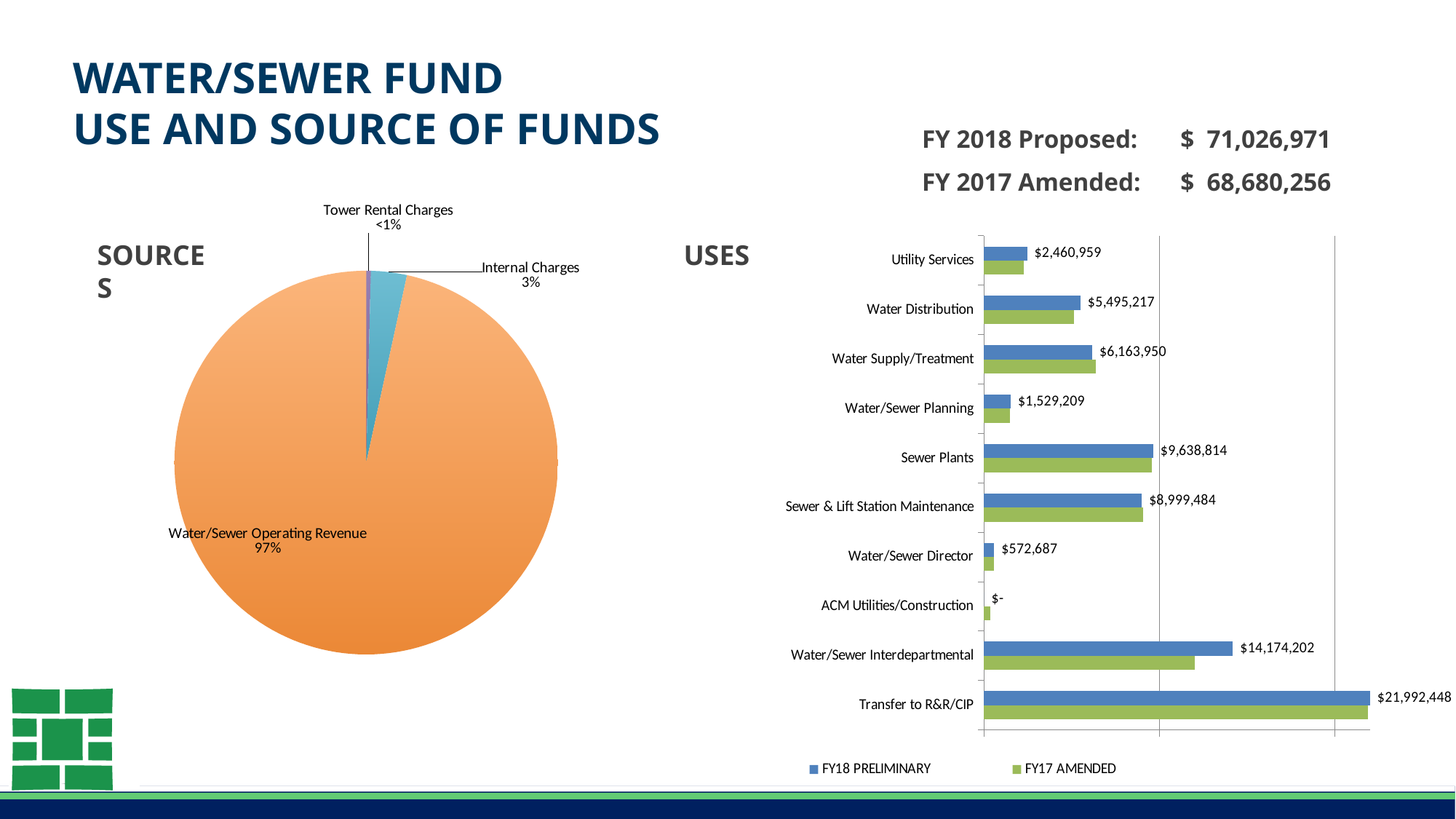
In the SOURCES pie chart, what share does Internal Charges represent? 3% How many series does the legend of the USES chart list? 2 In the USES chart, which category has the highest FY18 PRELIMINARY value? Transfer to R&R/CIP What kind of chart is the USES chart on the right? bar chart In the USES chart, what is the difference between the FY18 PRELIMINARY values for Sewer Plants and Sewer & Lift Station Maintenance? $639,330 In the USES chart, what is the FY18 PRELIMINARY value for Transfer to R&R/CIP? $21,992,448 In the USES chart, what is the FY18 PRELIMINARY value for Sewer Plants? $9,638,814 How many categories are shown in the USES bar chart? 10 How many slices does the SOURCES pie chart have? 3 In the SOURCES pie chart, what share does Water/Sewer Operating Revenue represent? 97% In the SOURCES pie chart, which slice is the largest? Water/Sewer Operating Revenue What kind of chart is the SOURCES chart on the left? pie chart